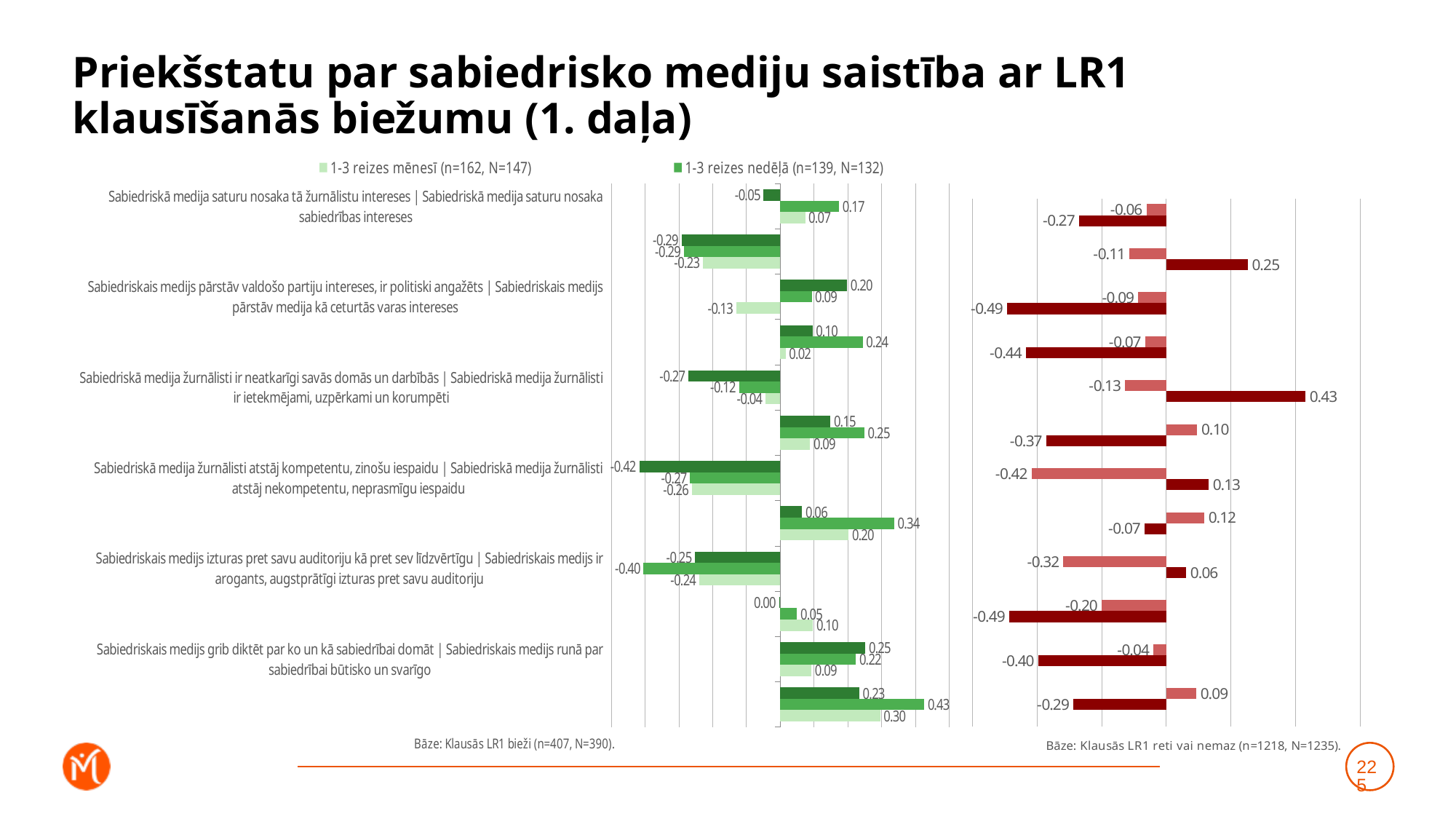
In the left (green) chart, what is the lowest data label value shown? -0.42 In the right (red) chart, which is larger: the value 0.25 or the value 0.13? 0.25 In the left (green) chart, what is the highest data label value shown? 0.43 In the right (red) chart, is the value -0.49 greater or less than 0? less How many statement labels are listed along the left side of the chart? 6 In the left (green) chart, what is the difference between the highest value 0.43 and the value 0.30 in the same bottom group? 0.13 What is the first series name shown in the legend? 1-3 reizes mēnesī (n=162, N=147) How many series does the legend at the top of the slide list? 2 In the right (red) chart, what is the lowest data label value shown? -0.49 What kind of chart is used on the left side of the slide? bar chart What is the second series name shown in the legend? 1-3 reizes nedēļā (n=139, N=132) In the right (red) chart, what is the highest data label value shown? 0.43